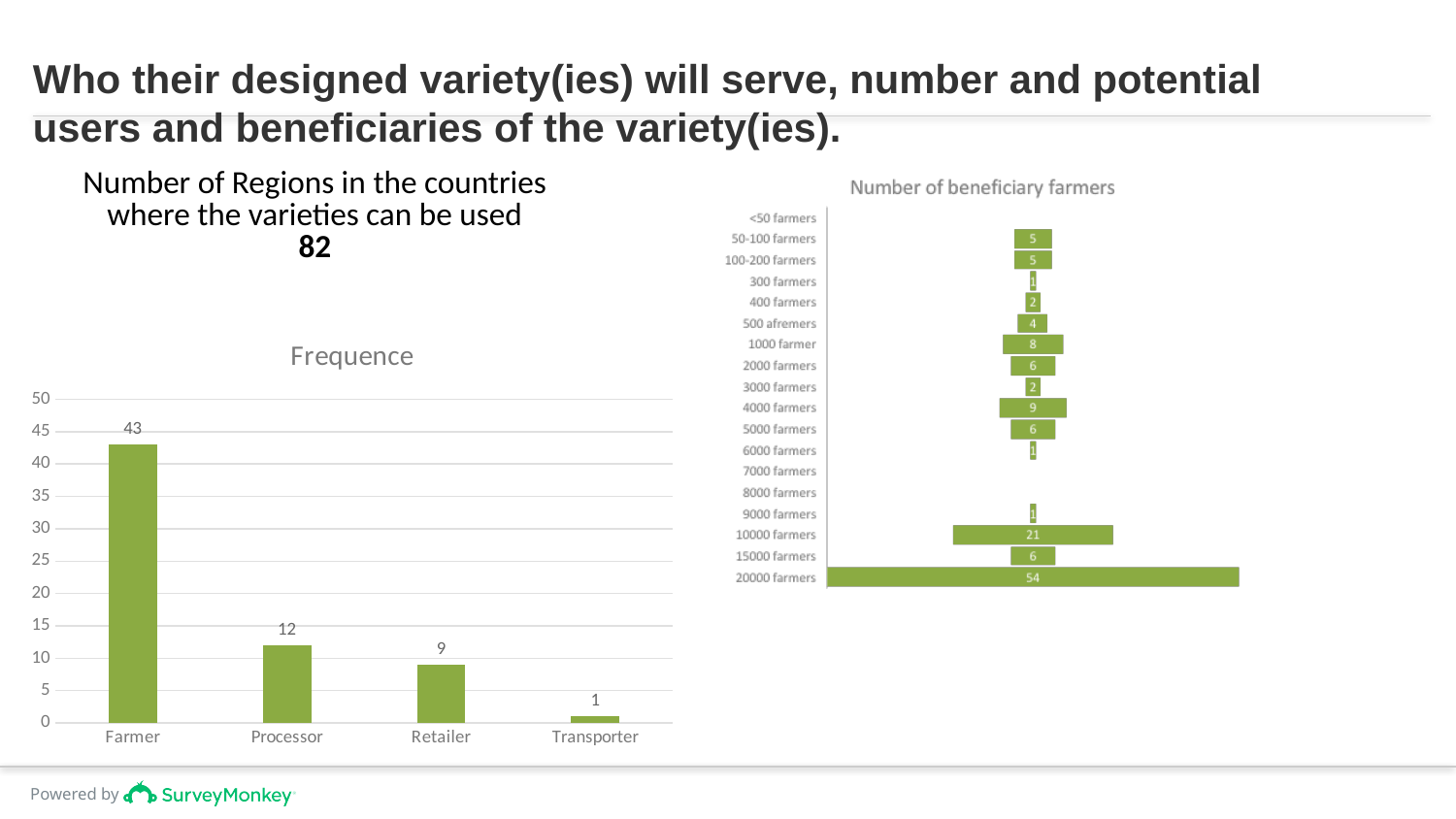
In the Frequence chart, what is the value for Processor? 12 In the Number of beneficiary farmers chart, what is the value for 10000 farmers? 21 In the Number of beneficiary farmers chart, which category has the highest value? 20000 farmers In the Number of beneficiary farmers chart, which is larger, the value for 4000 farmers or the value for 5000 farmers? 4000 farmers In the Frequence chart, how many categories are shown on the x axis? 4 In the Frequence chart, which category has the lowest value? Transporter What is the title of the chart on the right side of the slide? Number of beneficiary farmers In the Number of beneficiary farmers chart, what is the difference between the values for 20000 farmers and 10000 farmers? 33 What kind of chart is the Frequence chart? bar chart In the Frequence chart, what is the value for Farmer? 43 In the Frequence chart, what is the difference between the values for Farmer and Retailer? 34 In the Frequence chart, do the values rise or fall from Farmer to Transporter? fall